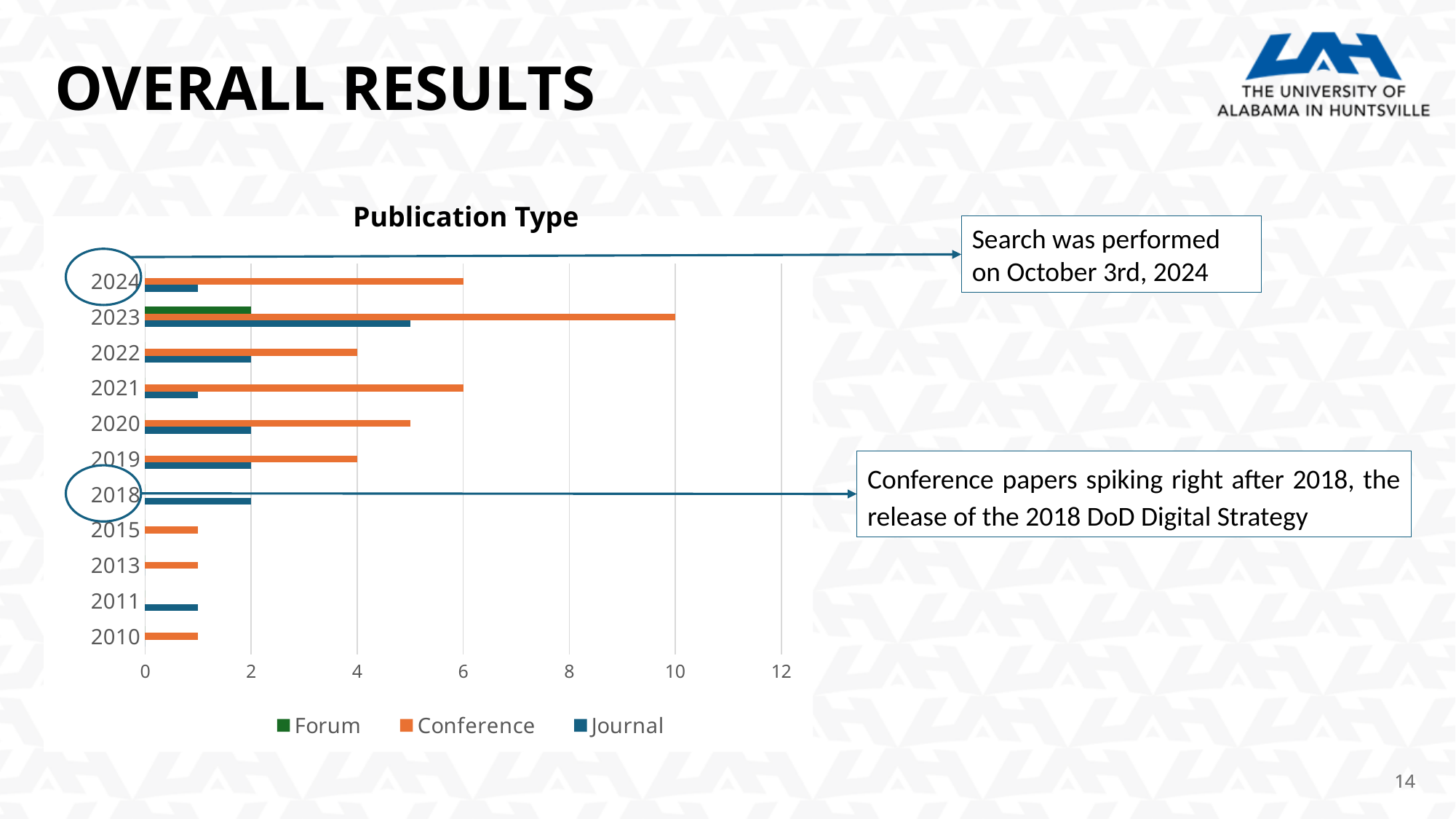
What is the difference between the Conference value for 2023 and the Conference value for 2024? 4 Which year has the highest Conference value in the Publication Type chart? 2023 What is the title of the chart? Publication Type What kind of chart is shown on the slide? bar chart What is the Journal value for 2022? 2 Is the Journal value for 2023 greater or less than 4? greater Which series is shown in green in the legend? Forum What is the Conference value for 2023? 10 What is the Conference value for 2024? 6 Which is larger, the Conference value for 2023 or the Conference value for 2021? 2023 How many years are shown on the y axis of the Publication Type chart? 11 How many series does the legend of the Publication Type chart list? 3